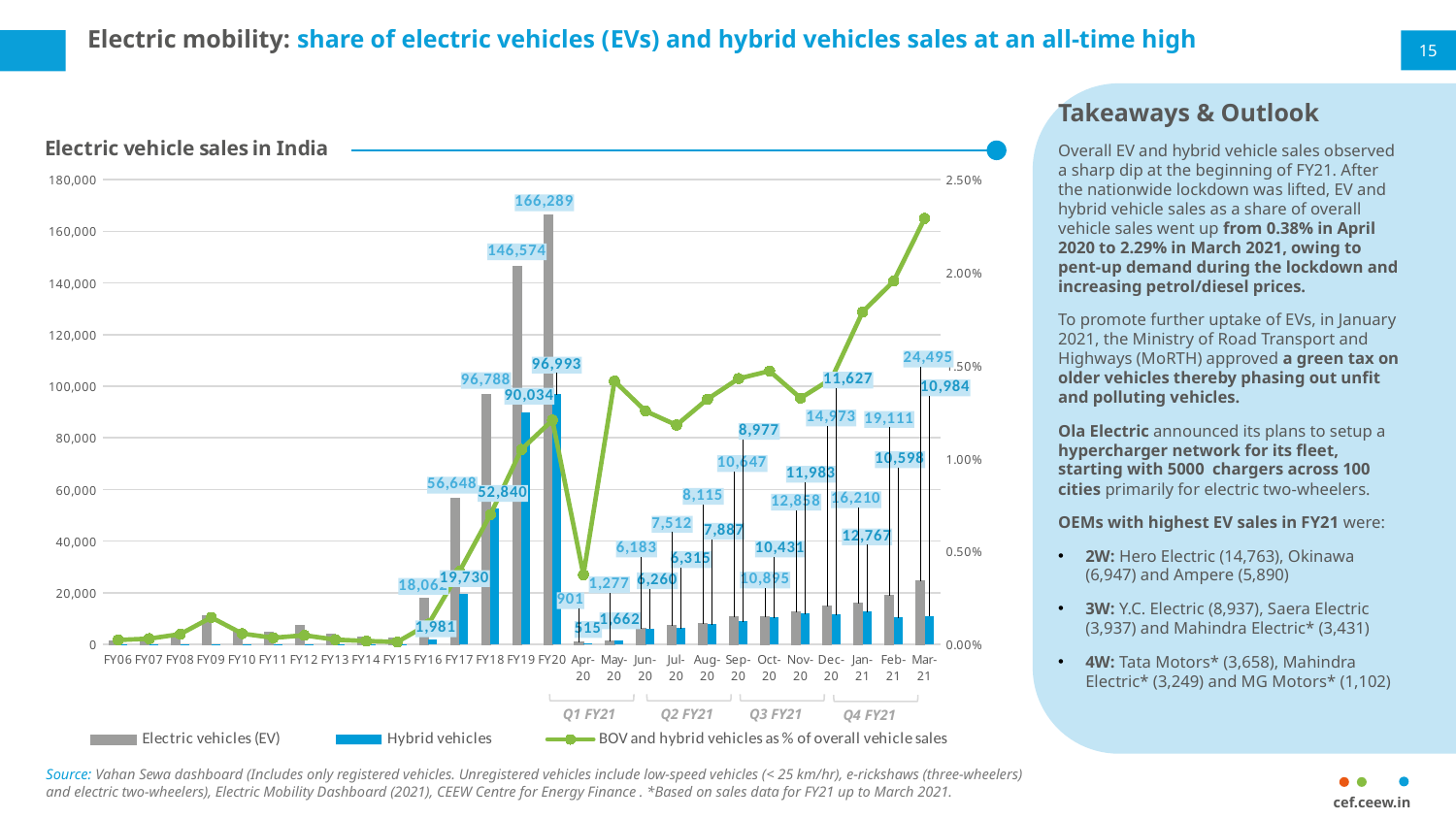
In the 'Electric vehicle sales in India' chart, is the 'BOV and hybrid vehicles as % of overall vehicle sales' value for Mar-21 greater or less than 2.00%? greater What is the title of the chart on the slide? Electric vehicle sales in India In the 'Electric vehicle sales in India' chart, what is the Electric vehicles (EV) value for FY17? 56,648 In the 'Electric vehicle sales in India' chart, what is the Electric vehicles (EV) value for FY18? 96,788 What kind of chart is 'Electric vehicle sales in India'? A combination bar and line chart In the 'Electric vehicle sales in India' chart, what is the difference between the Electric vehicles (EV) values for FY19 and FY18? 49,786 In the 'Electric vehicle sales in India' chart, what is the Electric vehicles (EV) value for Mar-21? 24,495 In the 'Electric vehicle sales in India' chart, what is the Hybrid vehicles value for FY16? 1,981 How many series does the legend of the 'Electric vehicle sales in India' chart list? 3 In the 'Electric vehicle sales in India' chart, what is the Electric vehicles (EV) value for FY19? 146,574 In the 'Electric vehicle sales in India' chart, which fiscal year has the highest Electric vehicles (EV) sales? FY20 In the 'Electric vehicle sales in India' chart, which has the larger Electric vehicles (EV) value, FY16 or FY17? FY17